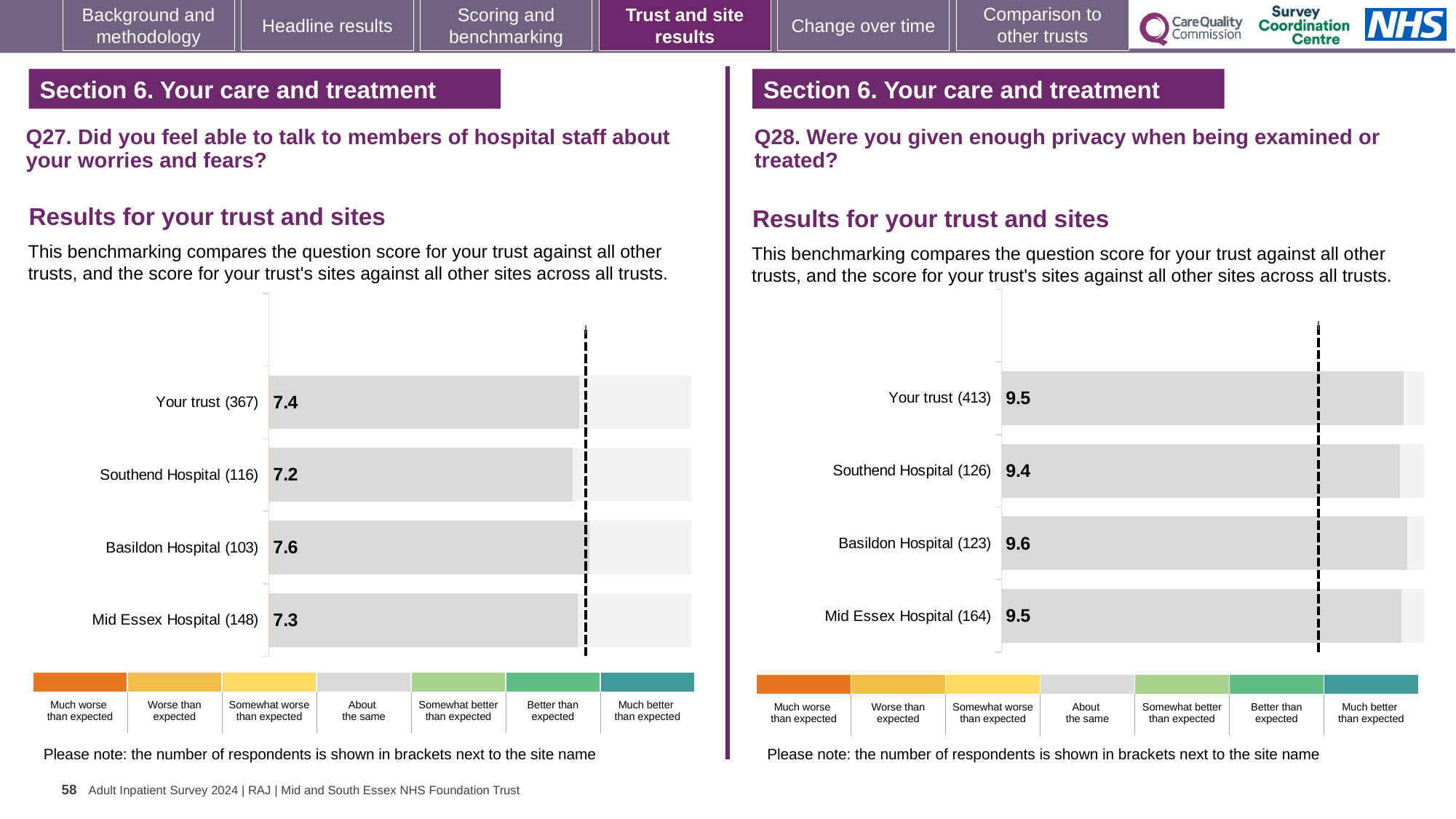
What type of chart is used for the Q27 results on the left? Bar chart In the Q28 chart on the right, which site has the highest score? Basildon Hospital In the Q28 chart on the right, which is larger, the score for Southend Hospital or the score for Basildon Hospital? Basildon Hospital In the Q27 chart on the left, what is the score for Southend Hospital? 7.2 How many bars are plotted in the Q28 chart on the right? 4 In the Q27 chart on the left, which bar has the highest score? Basildon Hospital In the Q27 chart on the left, what is the score for Basildon Hospital? 7.6 In the Q27 chart on the left, how many respondents are shown in brackets for Your trust? 367 In the Q27 chart on the left, what is the difference between the scores for Basildon Hospital and Mid Essex Hospital? 0.3 In the Q28 chart on the right, what is the score for Your trust? 9.5 In the Q27 chart on the left, which site has the lowest score? Southend Hospital In the Q28 chart on the right, what is the difference between the scores for Basildon Hospital and Southend Hospital? 0.2